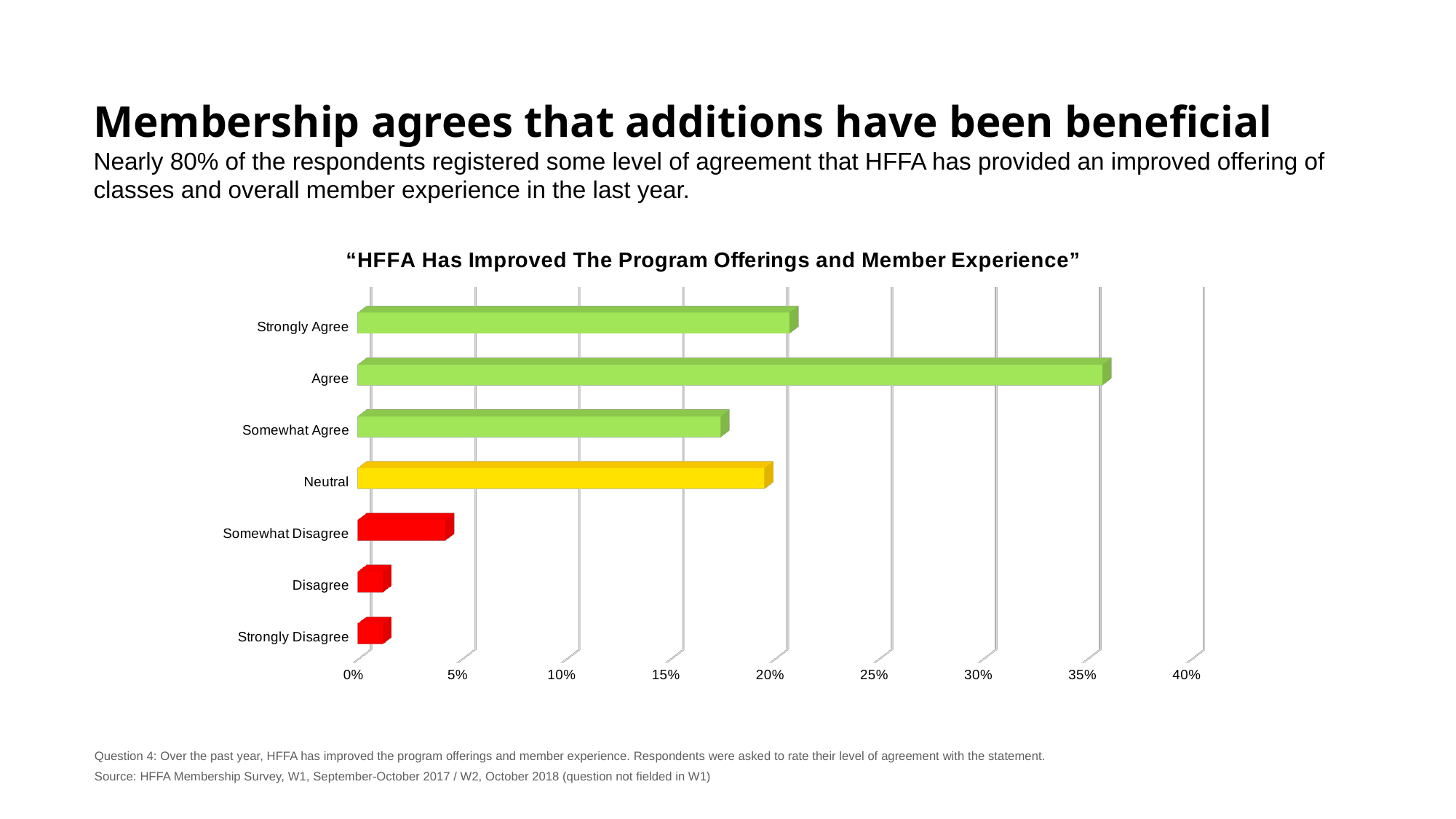
Is the value for Neutral greater or less than 15%? greater What is the title of the chart? "HFFA Has Improved The Program Offerings and Member Experience" Which response category has the highest value? Agree Is the value for Somewhat Disagree greater or less than 5%? less Is the value for Agree greater or less than 35%? greater What kind of chart is shown on the slide? Bar chart Which is larger, the value for Agree or the value for Strongly Agree? Agree How many response categories are shown in the chart? 7 What colour is the bar for Neutral? Yellow Which is larger, the value for Neutral or the value for Somewhat Agree? Neutral